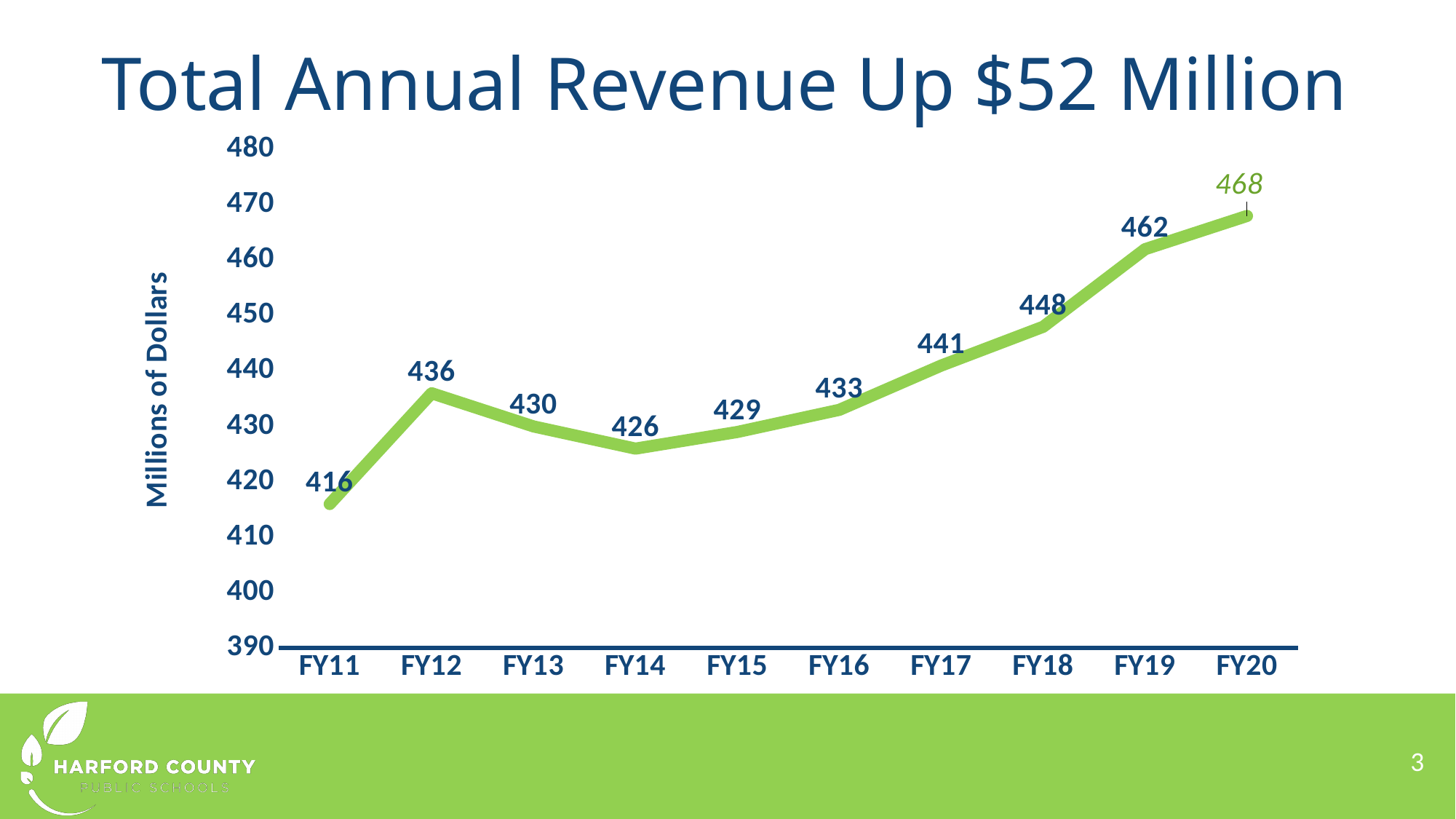
What is the revenue value for FY14? 426 What is the revenue value for FY20? 468 Do the values rise or fall from FY14 to FY20? Rise What is the difference between the FY20 and FY11 values? 52 Which is larger, the value for FY12 or the value for FY15? FY12 Which fiscal year has the lowest revenue? FY11 What kind of chart is shown on the slide? Line chart What is the revenue value for FY11? 416 Which fiscal year has the highest revenue? FY20 How many fiscal years are plotted on the chart? 10 What is the difference between the FY12 and FY14 values? 10 What is the label on the vertical axis? Millions of Dollars